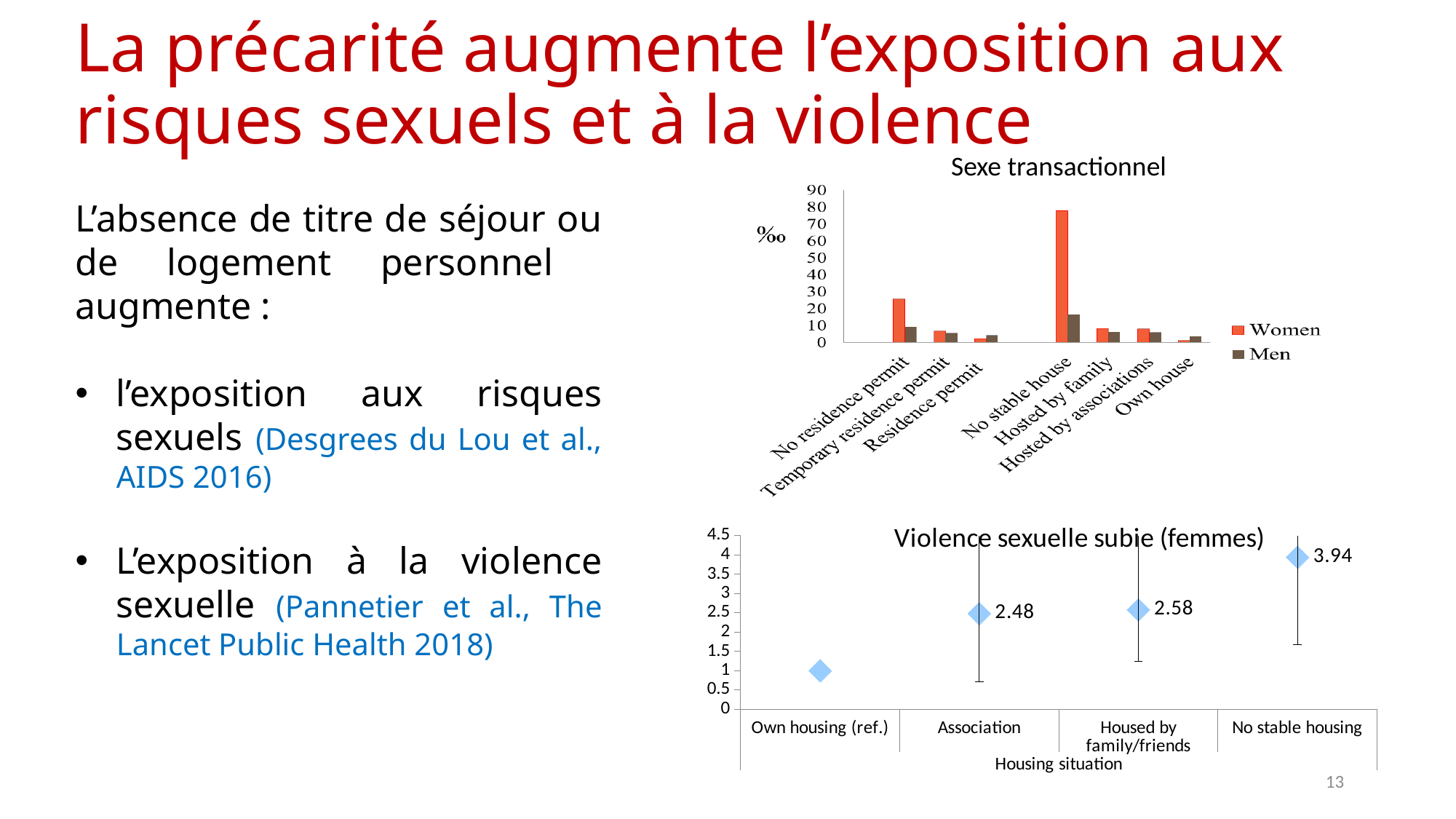
In the 'Violence sexuelle subie (femmes)' chart, what is the value for 'Association'? 2.48 In the 'Sexe transactionnel' chart, is the Women value for 'No residence permit' greater or less than 20? greater In the 'Violence sexuelle subie (femmes)' chart, which housing situation has the highest value? No stable housing How many series does the legend of the 'Sexe transactionnel' chart list? 2 What kind of chart is the 'Sexe transactionnel' chart? bar chart In the 'Violence sexuelle subie (femmes)' chart, what is the difference between the values for 'No stable housing' and 'Housed by family/friends'? 1.36 In the 'Violence sexuelle subie (femmes)' chart, what is the value for 'No stable housing'? 3.94 In the 'Sexe transactionnel' chart, for 'No stable house', which series has the larger value, Women or Men? Women In the 'Sexe transactionnel' chart, which category has the highest value for Women? No stable house In the 'Sexe transactionnel' chart, is the Women value for 'No stable house' greater or less than 70? greater In the 'Violence sexuelle subie (femmes)' chart, do the values rise or fall from left to right along the x axis? rise How many categories are shown on the x axis of the 'Sexe transactionnel' chart? 7